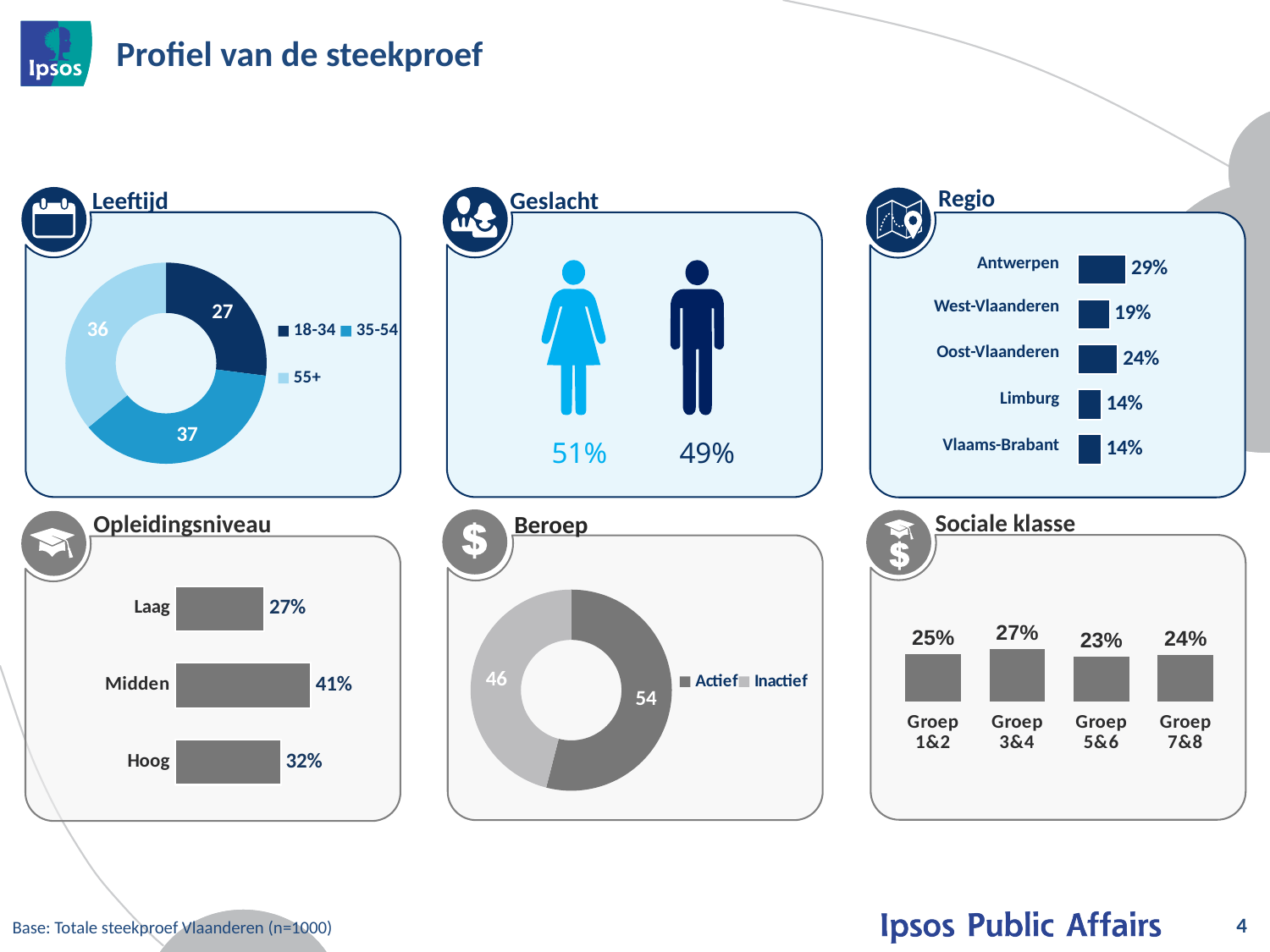
In the Regio chart, what is the difference between Antwerpen and West-Vlaanderen? 10% What kind of chart is the Sociale klasse chart? bar chart In the Beroep chart, what value is shown for Actief? 54 How many series does the legend of the Leeftijd chart list? 3 In the Leeftijd chart, what value is shown for the 18-34 group? 27 In the Leeftijd chart, which age group has the highest value? 35-54 In the Opleidingsniveau chart, which category has the lowest value? Laag In the Regio chart, what is the value for Antwerpen? 29% In the Sociale klasse chart, which group has the highest value? Groep 3&4 In the Regio chart, which region has the highest value? Antwerpen In the Opleidingsniveau chart, what is the value for Midden? 41% How many regions are shown in the Regio chart? 5